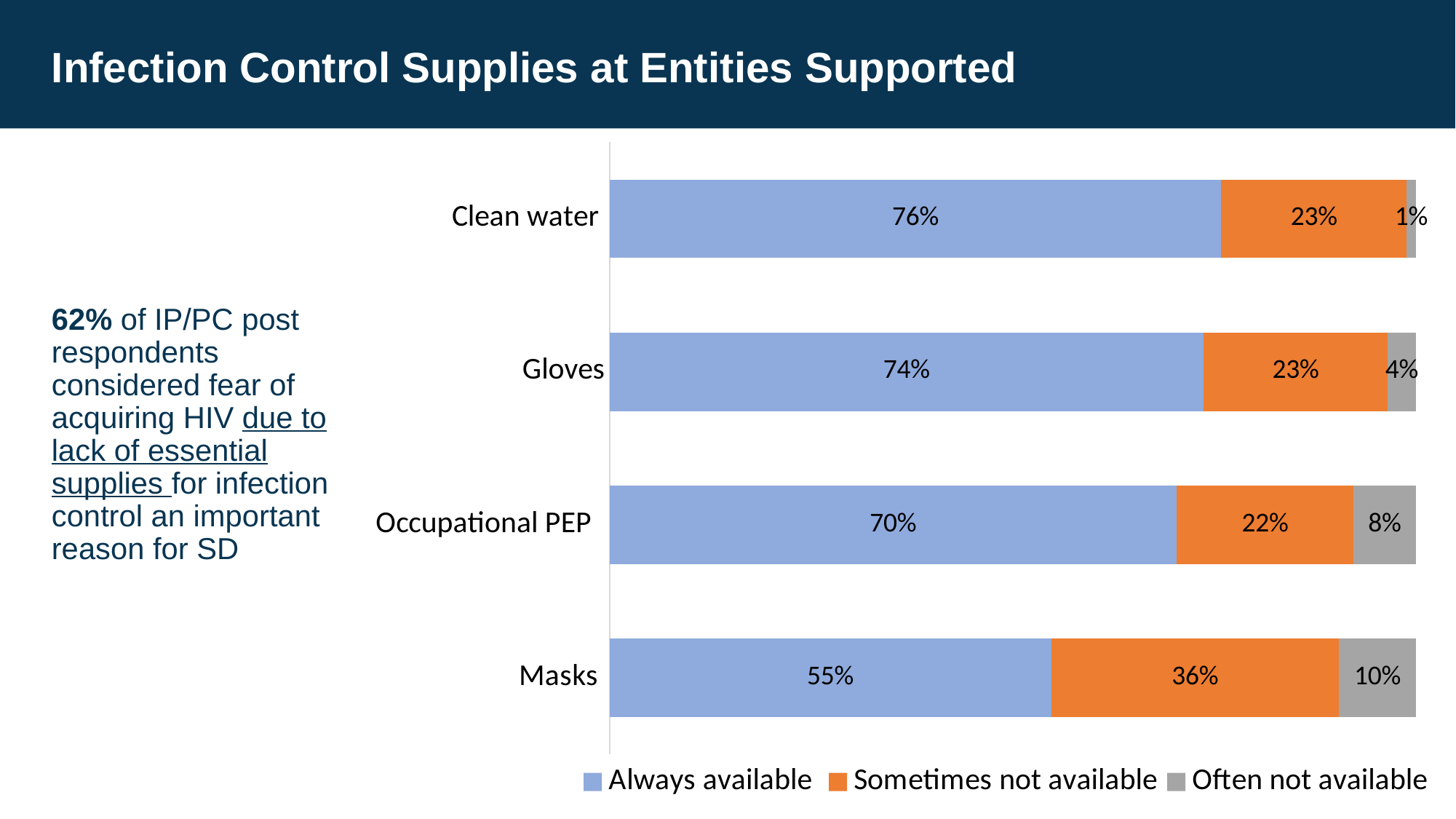
Which supply has the lowest 'Always available' percentage? Masks Which colour represents 'Sometimes not available' in the chart? Orange What is the 'Sometimes not available' value for Masks? 36% How many supply categories are shown in the chart? 4 Which supply has the highest 'Always available' percentage? Clean water Is the 'Sometimes not available' value larger for Masks or for Gloves? Masks What type of chart is shown on the slide? Stacked bar chart What is the 'Often not available' value for Occupational PEP? 8% How many series does the legend list? 3 Which supply has the highest 'Often not available' percentage? Masks What percentage of entities reported clean water as always available? 76% What is the difference between the 'Always available' percentages for Clean water and Masks? 21%